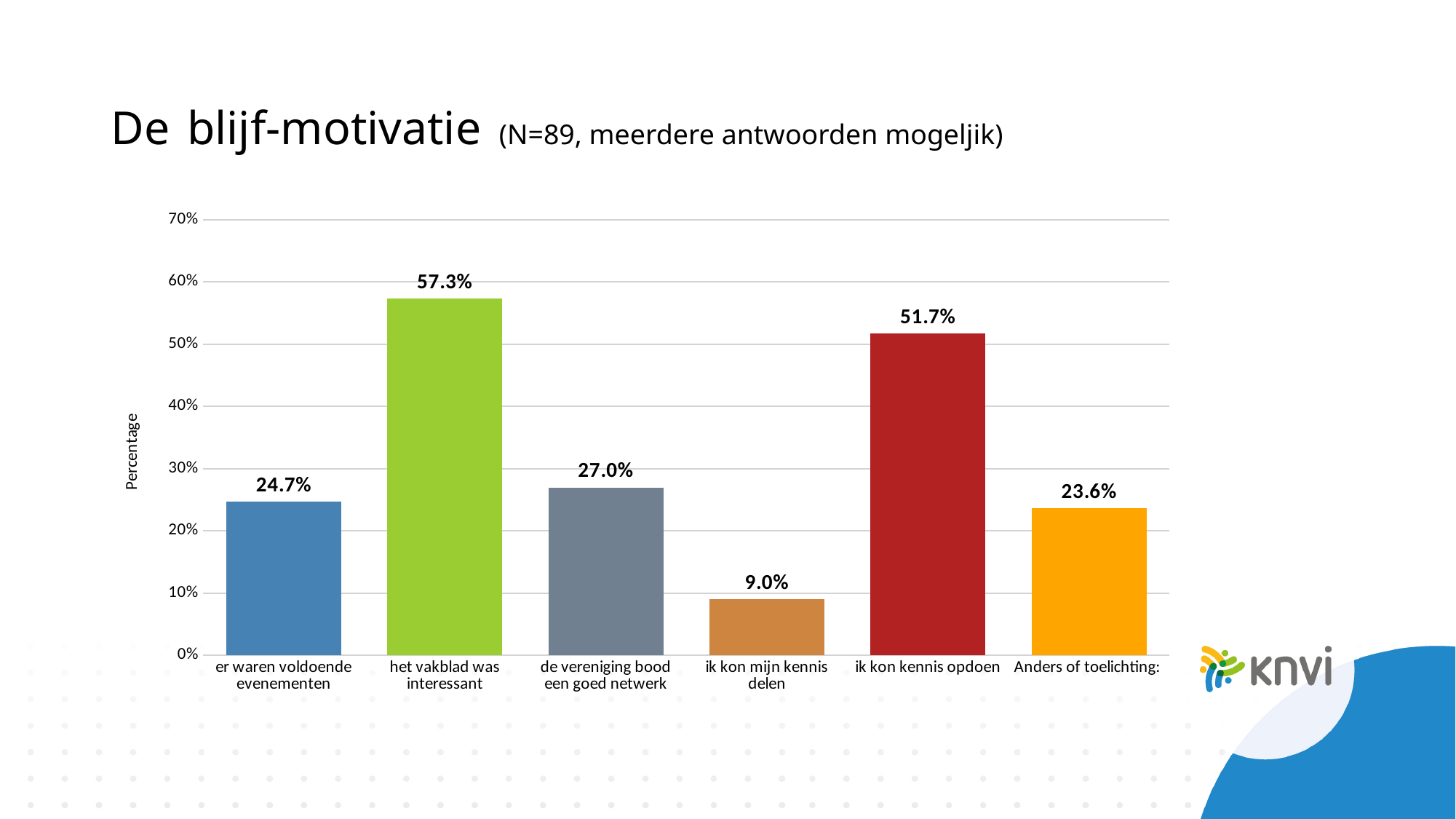
Which is larger: "er waren voldoende evenementen" or "de vereniging bood een goed netwerk"? de vereniging bood een goed netwerk What kind of chart is shown on the slide? bar chart What is the label of the vertical axis? Percentage What is the value for "het vakblad was interessant"? 57.3% What is the value for "Anders of toelichting:"? 23.6% What colour is the bar for "ik kon kennis opdoen"? red What is the value for "ik kon mijn kennis delen"? 9.0% Which category has the highest value? het vakblad was interessant How many categories are shown on the x axis? 6 Is the value for "ik kon kennis opdoen" greater or less than 50%? greater Which category has the lowest value? ik kon mijn kennis delen What is the difference between "het vakblad was interessant" and "ik kon kennis opdoen"? 5.6%